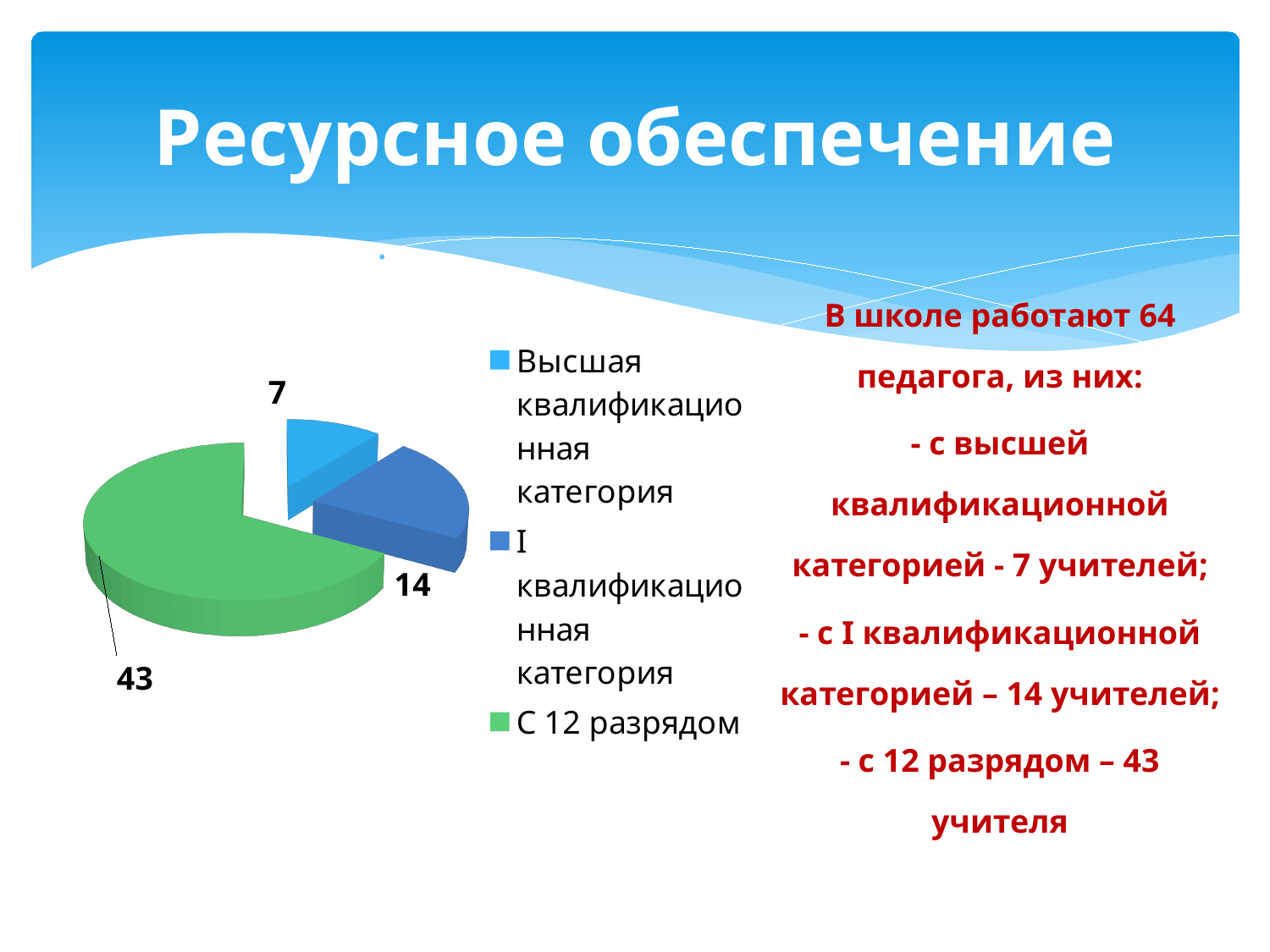
What is the difference between the values for 'С 12 разрядом' and 'I квалификационная категория'? 29 Which category has the smallest slice of the pie? Высшая квалификационная категория Which category has the largest slice of the pie? С 12 разрядом Which is larger: the value for 'I квалификационная категория' or for 'Высшая квалификационная категория'? I квалификационная категория What colour is the slice for 'С 12 разрядом'? green What is the value for the slice 'Высшая квалификационная категория'? 7 What type of chart is shown on the slide? pie chart How many slices does the pie chart have? 3 What is the difference between the values for 'I квалификационная категория' and 'Высшая квалификационная категория'? 7 What is the value for the slice 'I квалификационная категория'? 14 What is the total of all the slices in the pie chart? 64 What is the value for the slice 'С 12 разрядом'? 43